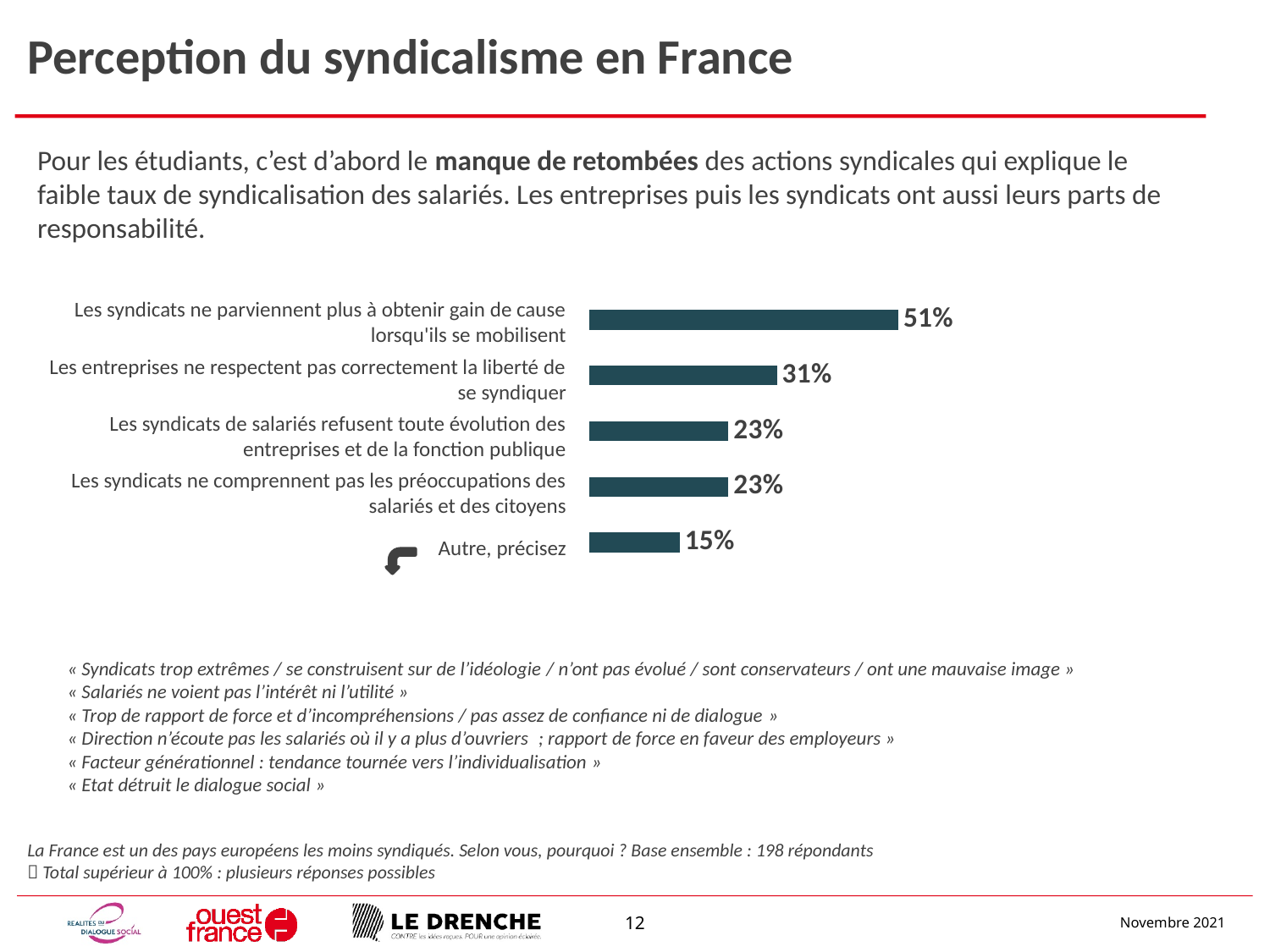
What kind of chart is shown on the slide? Bar chart What is the value for "Les syndicats ne comprennent pas les préoccupations des salariés et des citoyens"? 23% What is the difference between the values for "Les syndicats de salariés refusent toute évolution des entreprises et de la fonction publique" and "Autre, précisez"? 8% What is the value for "Les entreprises ne respectent pas correctement la liberté de se syndiquer"? 31% What is the value for "Les syndicats ne parviennent plus à obtenir gain de cause lorsqu'ils se mobilisent"? 51% How many categories are shown in the chart? 5 Which category has the lowest value? Autre, précisez How many categories share the value 23%? 2 Which category has the highest value? Les syndicats ne parviennent plus à obtenir gain de cause lorsqu'ils se mobilisent Which is larger: the value for "Les entreprises ne respectent pas correctement la liberté de se syndiquer" or the value for "Autre, précisez"? Les entreprises ne respectent pas correctement la liberté de se syndiquer What is the difference between the values for "Les syndicats ne parviennent plus à obtenir gain de cause lorsqu'ils se mobilisent" and "Les entreprises ne respectent pas correctement la liberté de se syndiquer"? 20% What is the value for "Autre, précisez"? 15%